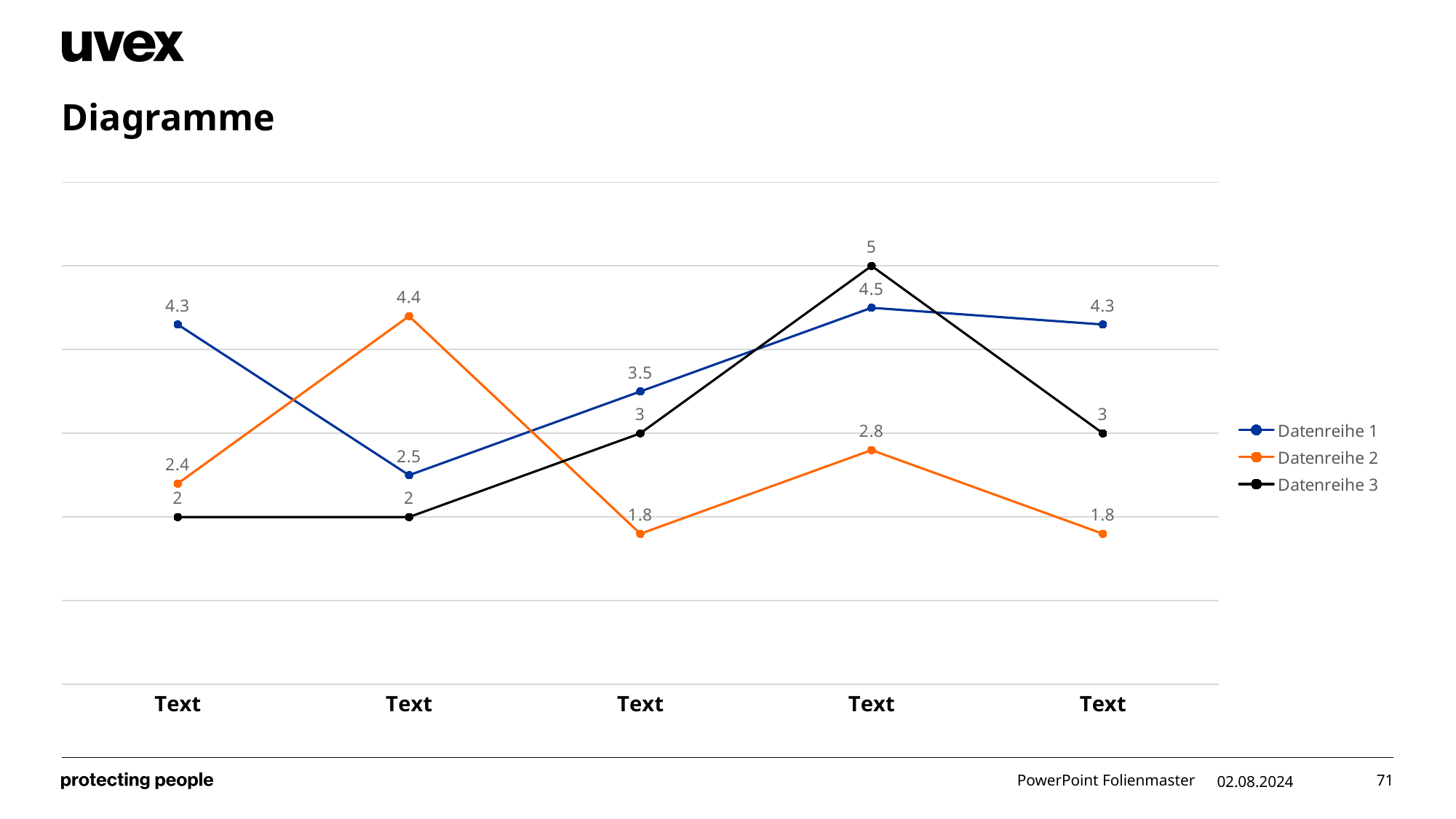
What is the title of the slide containing the chart? Diagramme What is the value of Datenreihe 1 at the first category? 4.3 What is the value of Datenreihe 3 at the fourth category? 5 What kind of chart is shown on the slide? line chart How many categories are plotted along the x axis? 5 Which series has the highest value at the fourth category? Datenreihe 3 What is the difference between Datenreihe 1 and Datenreihe 3 at the fifth category? 1.3 Which series has the lowest value at the third category? Datenreihe 2 How many series does the legend list? 3 Does Datenreihe 3 rise or fall from the third category to the fourth category? rise At the second category, which is larger: Datenreihe 1 or Datenreihe 2? Datenreihe 2 What is the value of Datenreihe 2 at the second category? 4.4